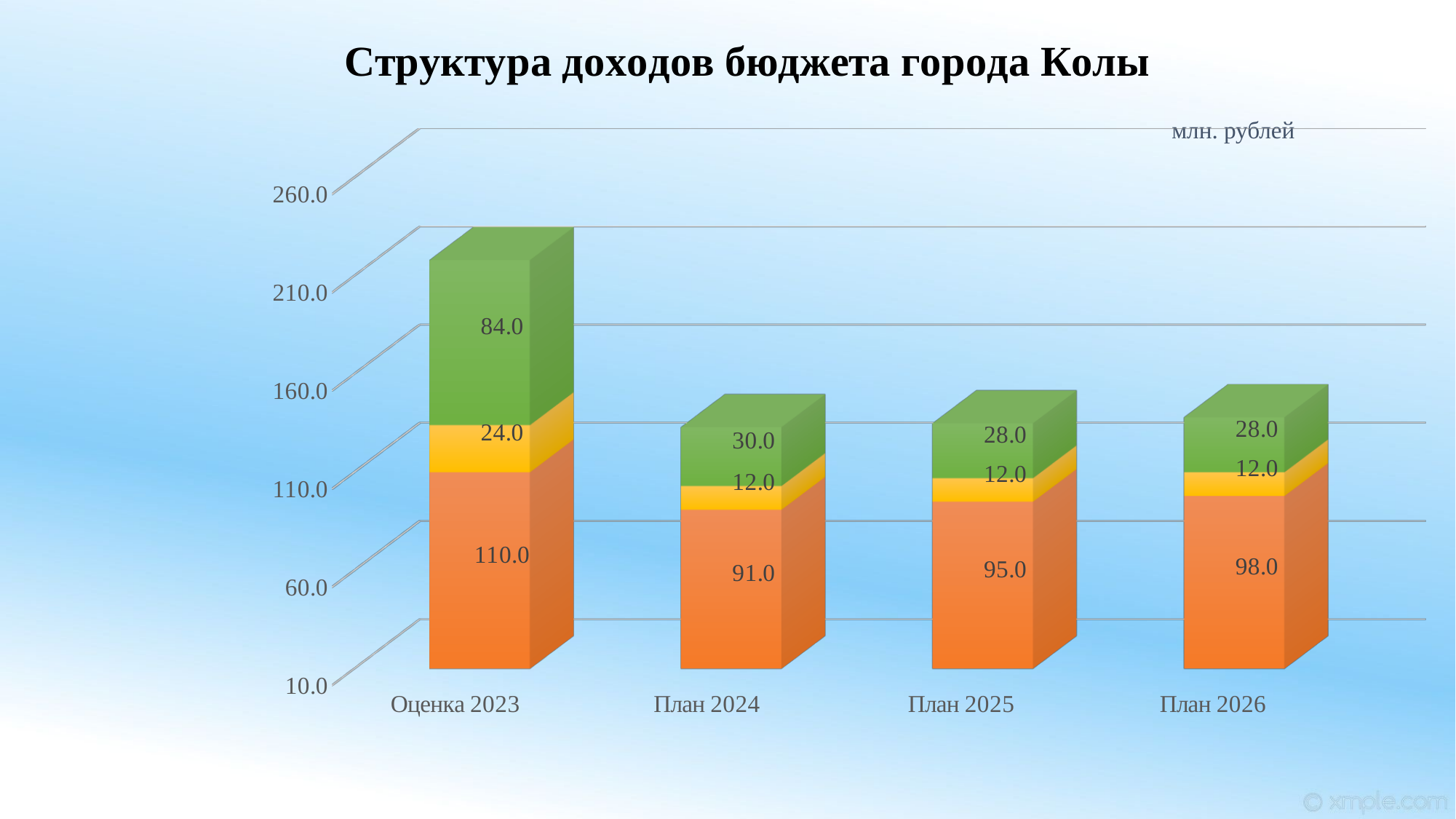
What is the difference between the orange segment values for План 2026 and План 2024? 7.0 Which category has the lowest value for the orange (bottom) segment? План 2024 What is the value of the orange (bottom) segment for Оценка 2023? 110.0 What is the total of the stacked bar for Оценка 2023? 218.0 Which category has the highest value for the green (top) segment? Оценка 2023 What is the value of the green (top) segment for План 2024? 30.0 What kind of chart is shown on the slide? Stacked bar chart What is the total of the stacked bar for План 2025? 135.0 How many categories are shown on the x axis? 4 What is the value of the yellow (middle) segment for План 2026? 12.0 What is the title of the chart? Структура доходов бюджета города Колы Which is larger: the green segment for План 2024 or the green segment for План 2025? План 2024